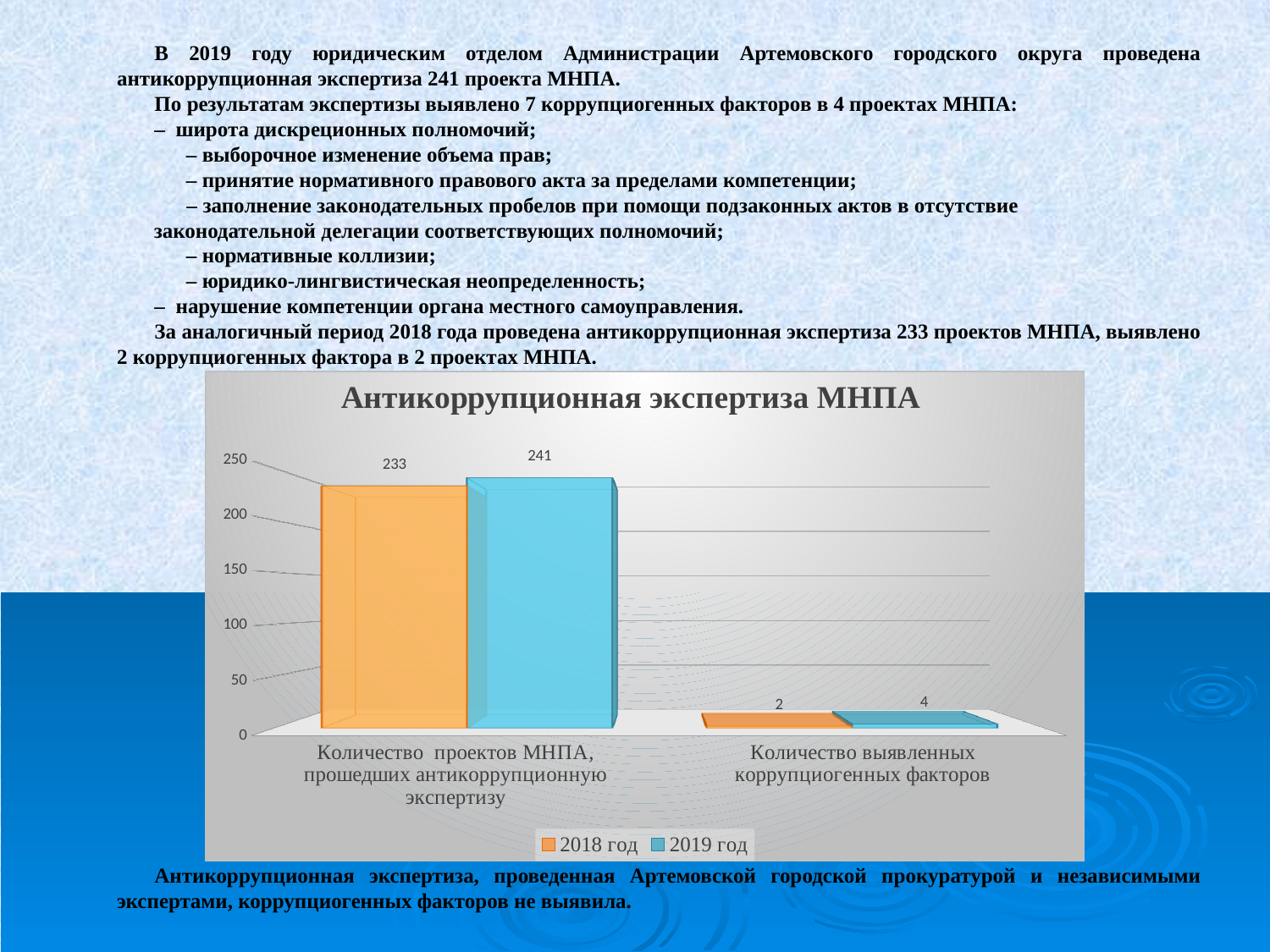
What is the value for 2019 год for 'Количество проектов МНПА, прошедших антикоррупционную экспертизу'? 241 What is the value for 2018 год for 'Количество проектов МНПА, прошедших антикоррупционную экспертизу'? 233 What is the value for 2018 год for 'Количество выявленных коррупциогенных факторов'? 2 What is the difference between the 2019 год and 2018 год values for 'Количество выявленных коррупциогенных факторов'? 2 What is the difference between the 2019 год and 2018 год values for 'Количество проектов МНПА, прошедших антикоррупционную экспертизу'? 8 What is the value for 2019 год for 'Количество выявленных коррупциогенных факторов'? 4 How many categories are shown on the x axis of the chart? 2 How many series does the chart legend list? 2 Which series has the larger value for 'Количество выявленных коррупциогенных факторов', 2018 год or 2019 год? 2019 год Is the 2018 год value for 'Количество проектов МНПА, прошедших антикоррупционную экспертизу' greater or less than 200? greater What is the title of the chart? Антикоррупционная экспертиза МНПА What kind of chart is shown on the slide? bar chart